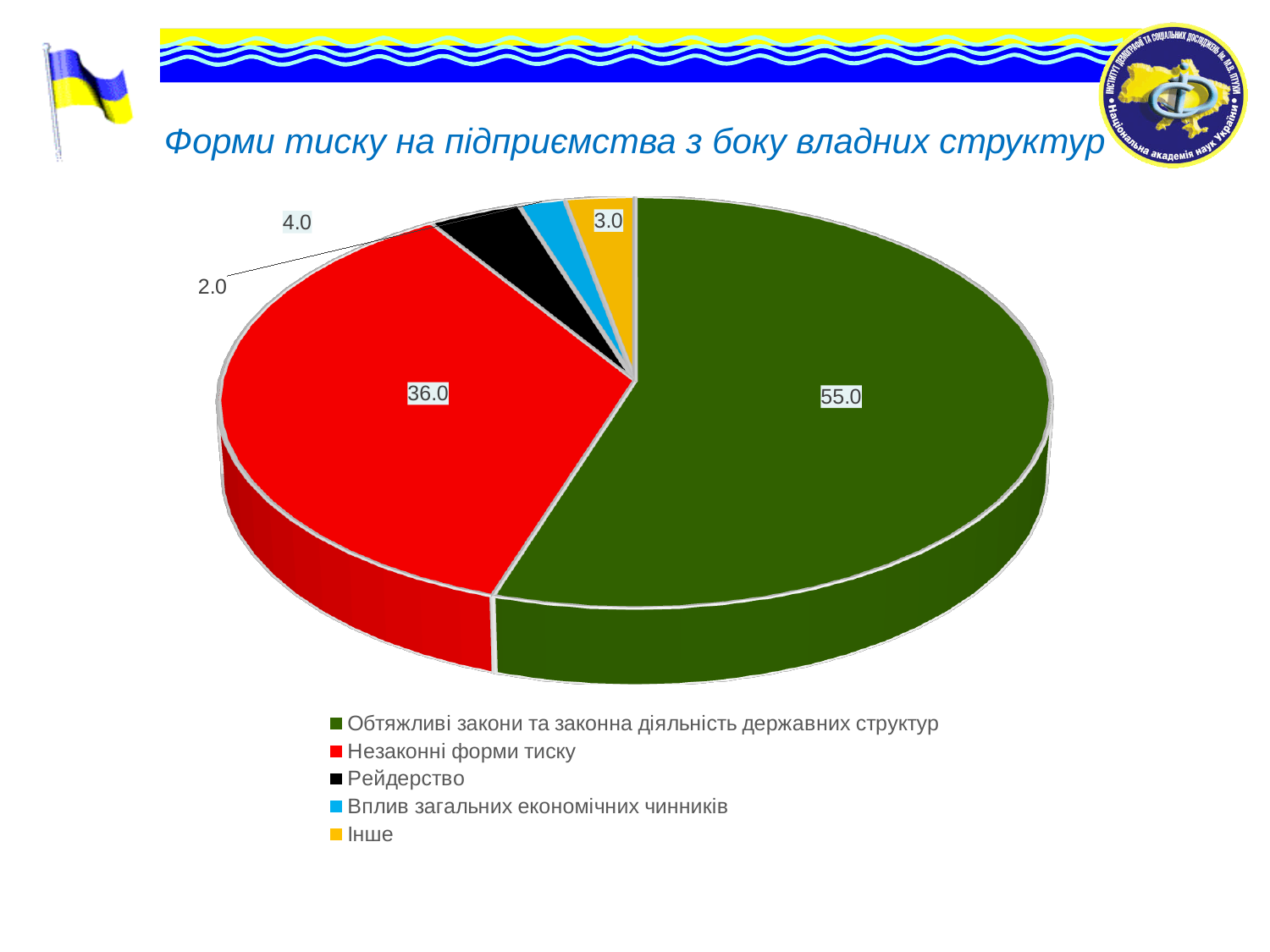
What is the title of the chart? Форми тиску на підприємства з боку владних структур What is the value for Незаконні форми тиску? 36.0 Which is larger, the value for Рейдерство or the value for Інше? Рейдерство What is the value for Рейдерство? 4.0 What is the value for Інше? 3.0 Which category has the smallest slice? Вплив загальних економічних чинників What is the value for Вплив загальних економічних чинників? 2.0 What is the difference between the values for Обтяжливі закони та законна діяльність державних структур and Незаконні форми тиску? 19.0 Which category has the largest slice? Обтяжливі закони та законна діяльність державних структур What is the value for Обтяжливі закони та законна діяльність державних структур? 55.0 What kind of chart is shown on the slide? Pie chart How many categories does the pie chart show? 5